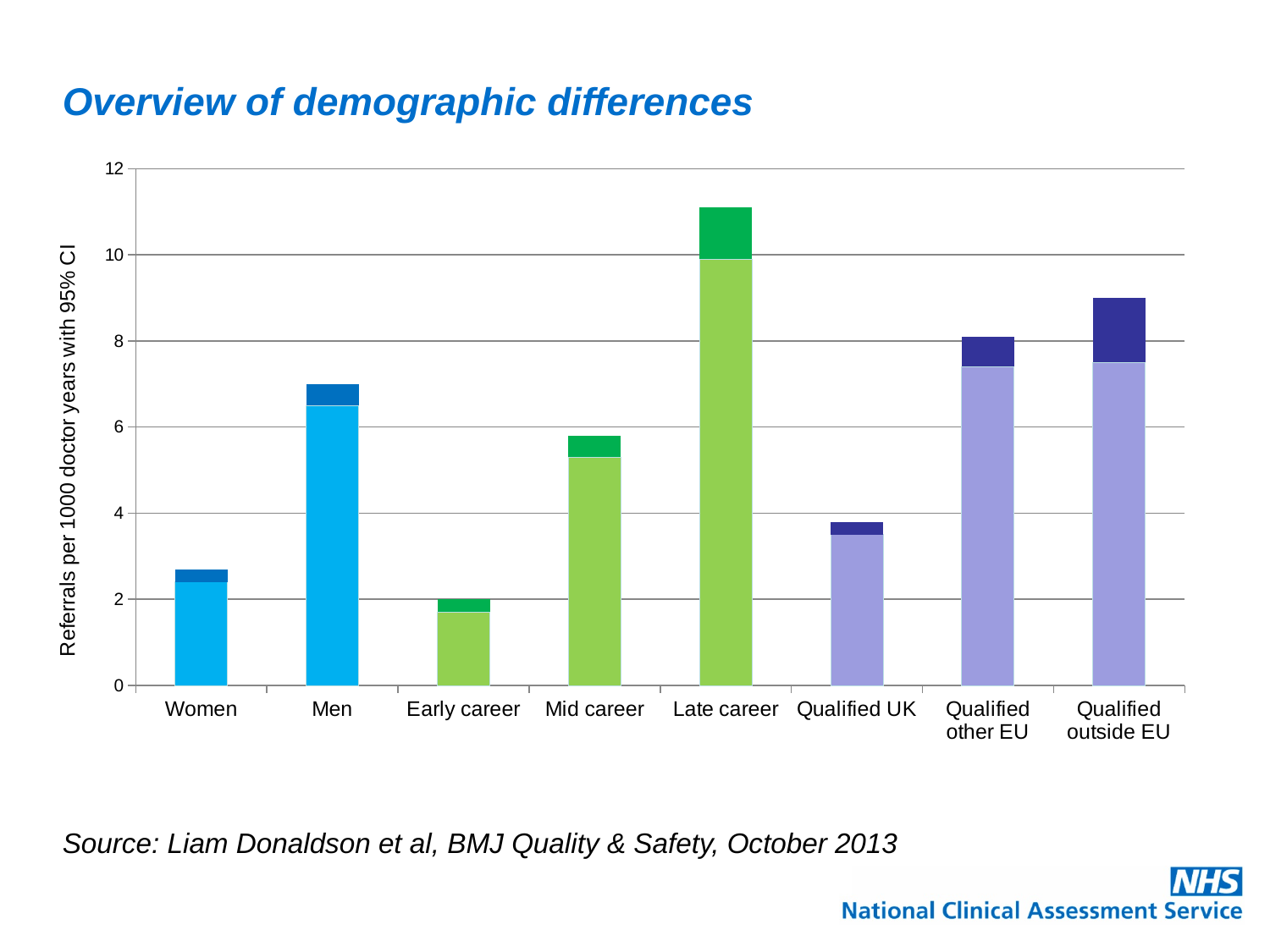
Is the value for Qualified UK greater or less than 4? less Is the value for Men greater or less than 6? greater Which has the larger value, Women or Men? Men Which has the larger value, Qualified UK or Qualified outside EU? Qualified outside EU Which category has the highest bar in the chart? Late career Is the value for Women greater or less than 4? less What is the title of the slide containing the chart? Overview of demographic differences What kind of chart is shown on the slide? bar chart What is the label on the y axis of the chart? Referrals per 1000 doctor years with 95% CI How many categories are shown on the x axis of the chart? 8 Which category has the lowest bar in the chart? Early career